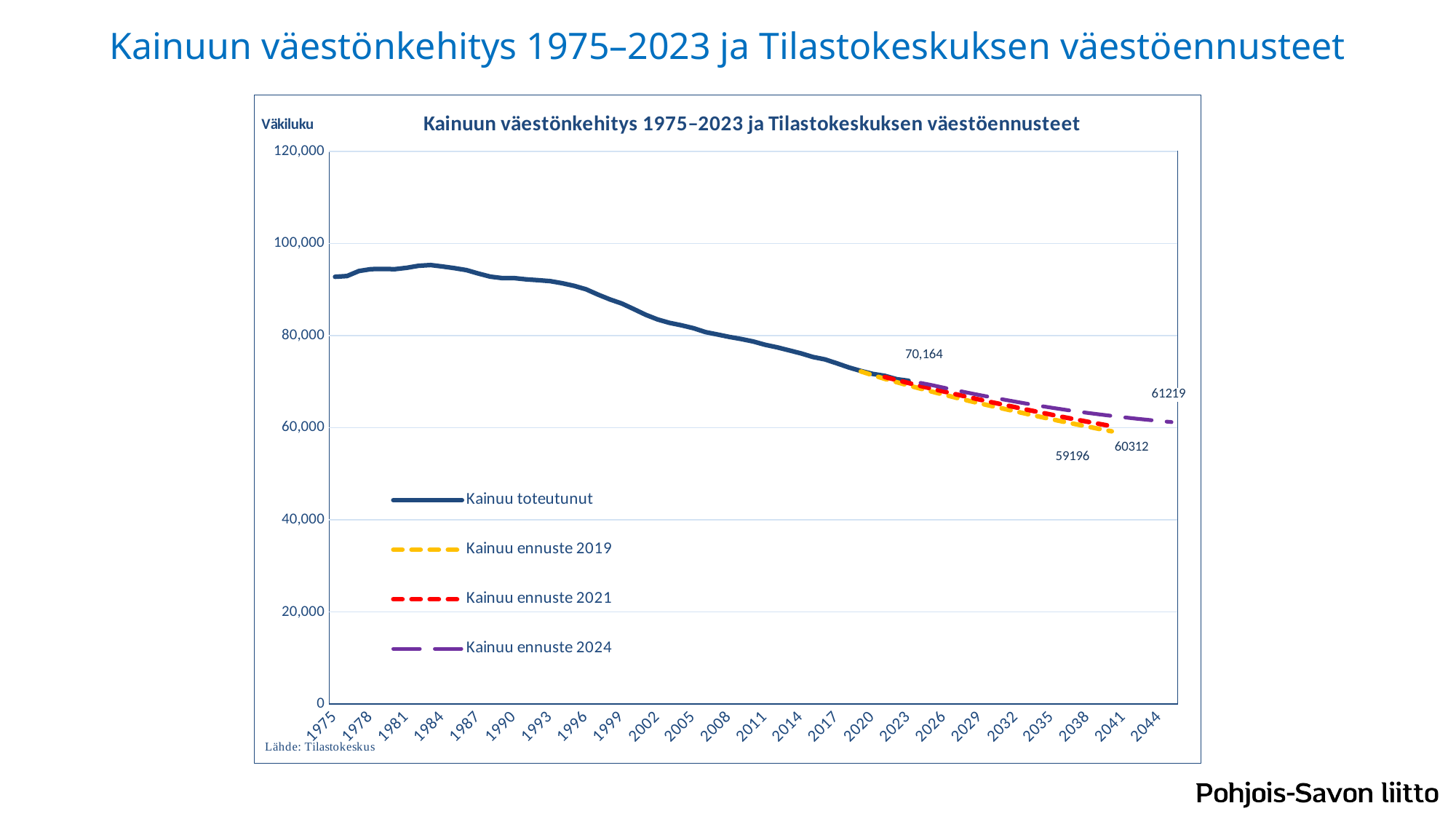
What is the label on the vertical axis of the chart? Väkiluku Does the Kainuu toteutunut series rise or fall overall from 1975 to 2023? fall What is the labelled end value of the Kainuu ennuste 2019 series? 59196 What is the labelled value at the end of the Kainuu toteutunut series? 70,164 What is the labelled end value of the Kainuu ennuste 2024 series? 61219 Which ends higher, the Kainuu ennuste 2021 series or the Kainuu ennuste 2024 series? Kainuu ennuste 2024 How many series does the legend list? 4 Which forecast series ends at the lowest value? Kainuu ennuste 2019 Is the Kainuu toteutunut value in 1975 greater or less than 90,000? greater What is the labelled end value of the Kainuu ennuste 2021 series? 60312 What kind of chart is shown on the slide? line chart What is the difference between the end values of Kainuu ennuste 2024 (61219) and Kainuu ennuste 2019 (59196)? 2023